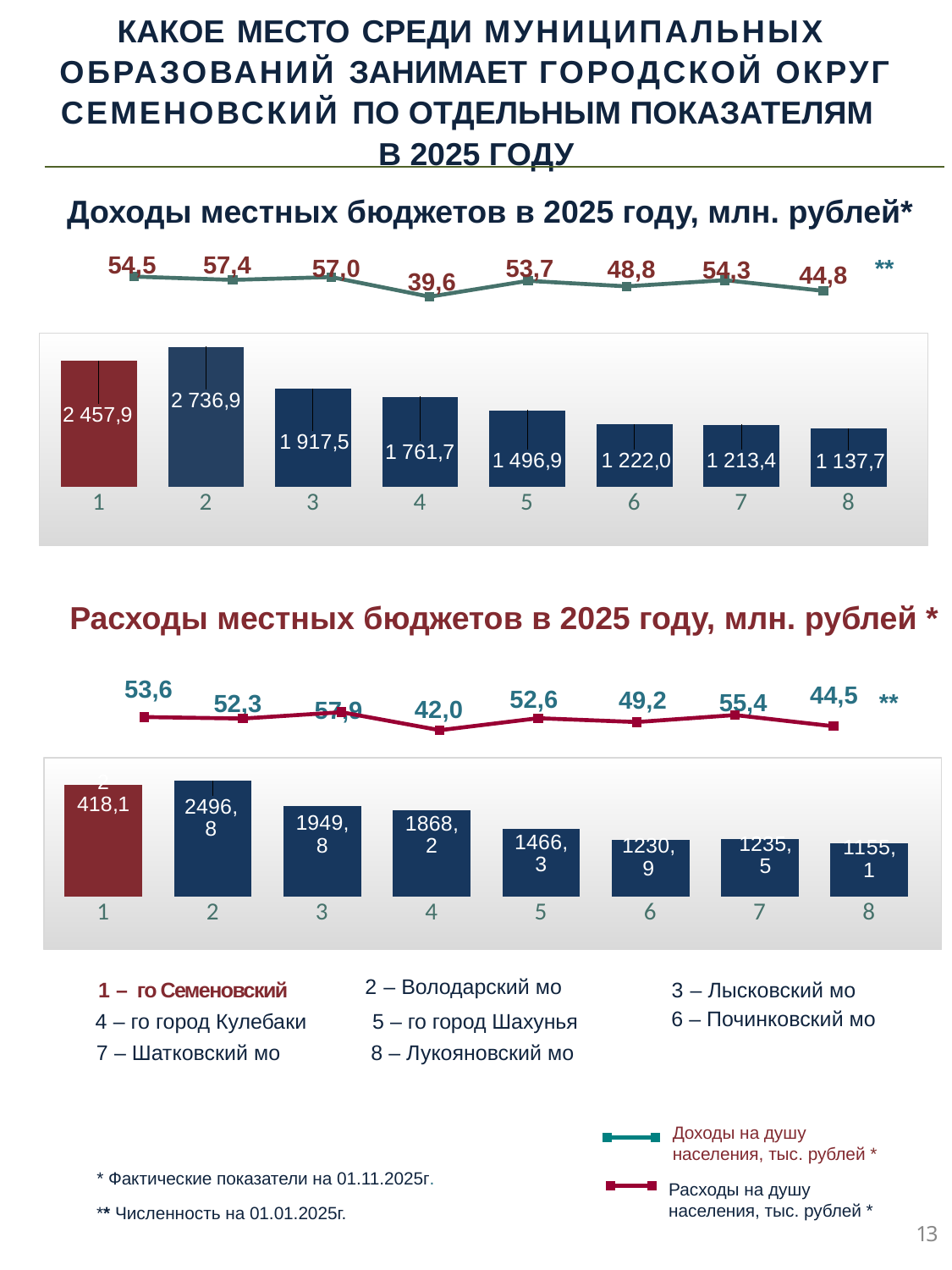
In the chart 'Доходы местных бюджетов в 2025 году, млн. рублей*', what is the per-capita income (line value) for category 4? 39,6 In the chart 'Расходы местных бюджетов в 2025 году, млн. рублей *', what is the per-capita expenditure (line value) for category 8? 44,5 In the chart 'Доходы местных бюджетов в 2025 году, млн. рублей*', what is the difference between the bar values for category 1 and category 2? 279,0 In the chart 'Доходы местных бюджетов в 2025 году, млн. рублей*', which category has the lowest bar value? 8 What type of chart is used for the budget values in 'Расходы местных бюджетов в 2025 году, млн. рублей *'? Bar chart In the chart 'Доходы местных бюджетов в 2025 году, млн. рублей*', what is the bar value for category 2? 2 736,9 In the chart 'Расходы местных бюджетов в 2025 году, млн. рублей *', what is the bar value for category 3? 1949,8 In the chart 'Расходы местных бюджетов в 2025 году, млн. рублей *', which category has the highest per-capita expenditure line value? 3 In the chart 'Доходы местных бюджетов в 2025 году, млн. рублей*', what is the bar value for category 1? 2 457,9 In the chart 'Доходы местных бюджетов в 2025 году, млн. рублей*', which category has the highest bar value? 2 In the chart 'Расходы местных бюджетов в 2025 году, млн. рублей *', which is larger, the bar value for category 6 or for category 7? 7 In the chart 'Доходы местных бюджетов в 2025 году, млн. рублей*', how many categories are shown on the x axis? 8